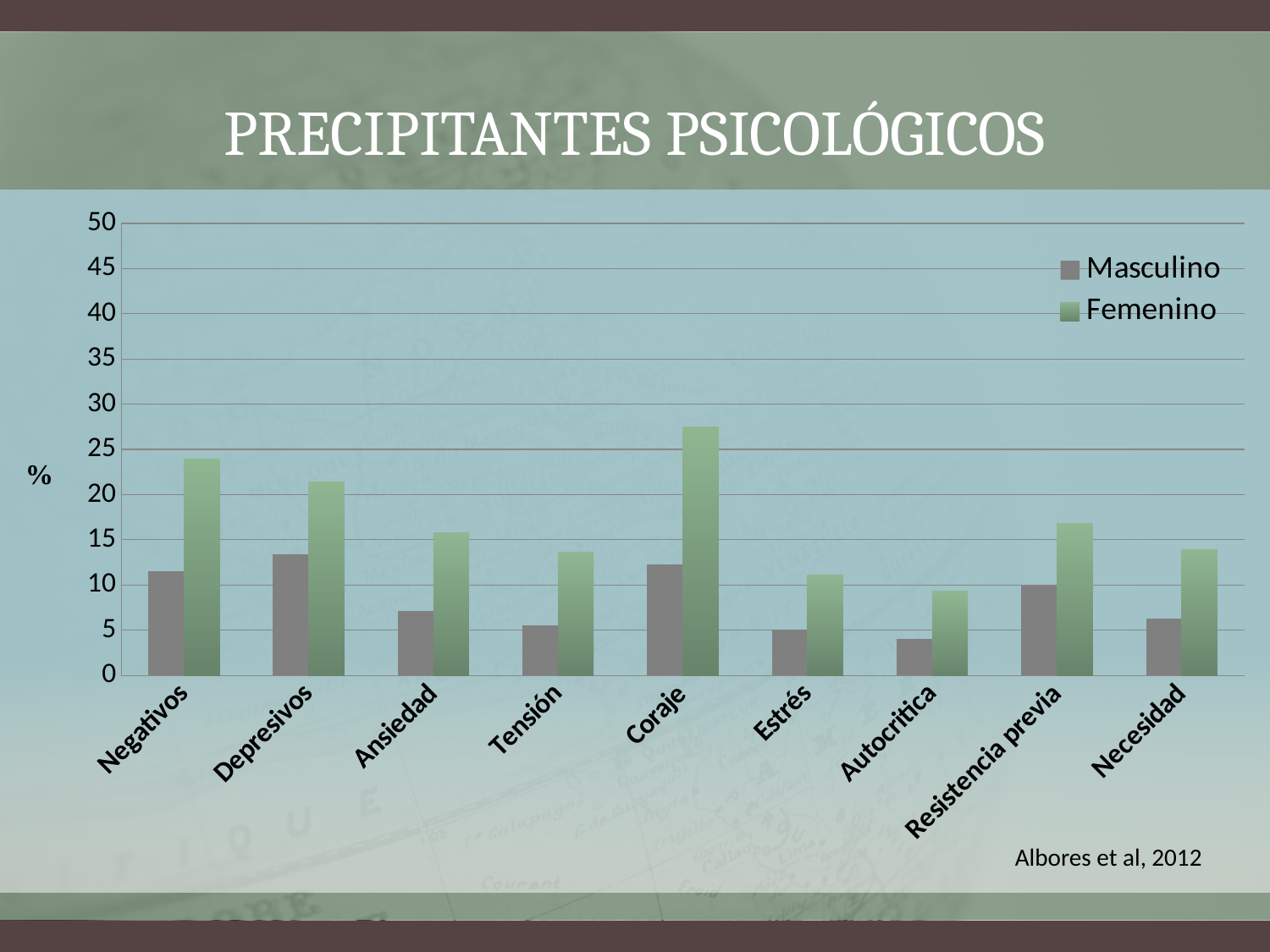
Which category has the lowest Femenino value? Autocrítica Is the Femenino value for Coraje greater or less than 25? greater Is the Femenino value for Autocrítica greater or less than 10? less For Coraje, which series has the larger value, Masculino or Femenino? Femenino What kind of chart is shown on the slide? Bar chart Which is larger, the Femenino value for Negativos or the Femenino value for Depresivos? Negativos What is the title of the chart on the slide? PRECIPITANTES PSICOLÓGICOS Which category has the highest Femenino value? Coraje How many series does the legend list? 2 Is the Femenino value for Negativos greater or less than 20? greater How many categories are shown on the x axis? 9